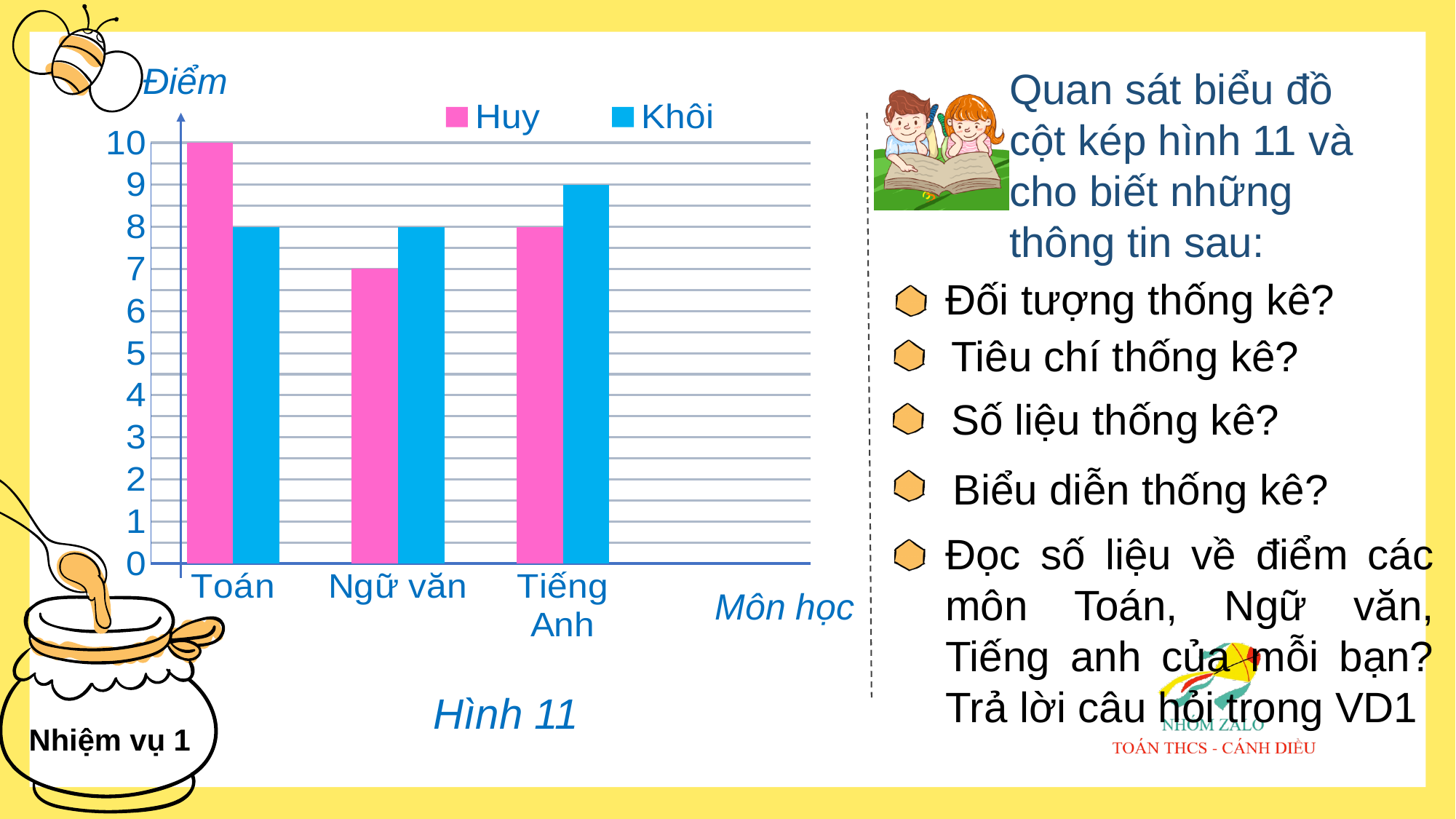
How many subjects are shown on the x axis? 3 In which subject does Khôi have the highest score? Tiếng Anh What kind of chart is shown in Hình 11? Bar chart What is Huy's score for Ngữ văn? 7 In which subject does Huy have the highest score? Toán In which subject does Huy have the lowest score? Ngữ văn What is Huy's score for Toán? 10 What is Khôi's score for Tiếng Anh? 9 What is Khôi's score for Toán? 8 Who has the higher score for Ngữ văn, Huy or Khôi? Khôi How many series does the legend list? 2 What is the difference between Huy's and Khôi's scores for Toán? 2